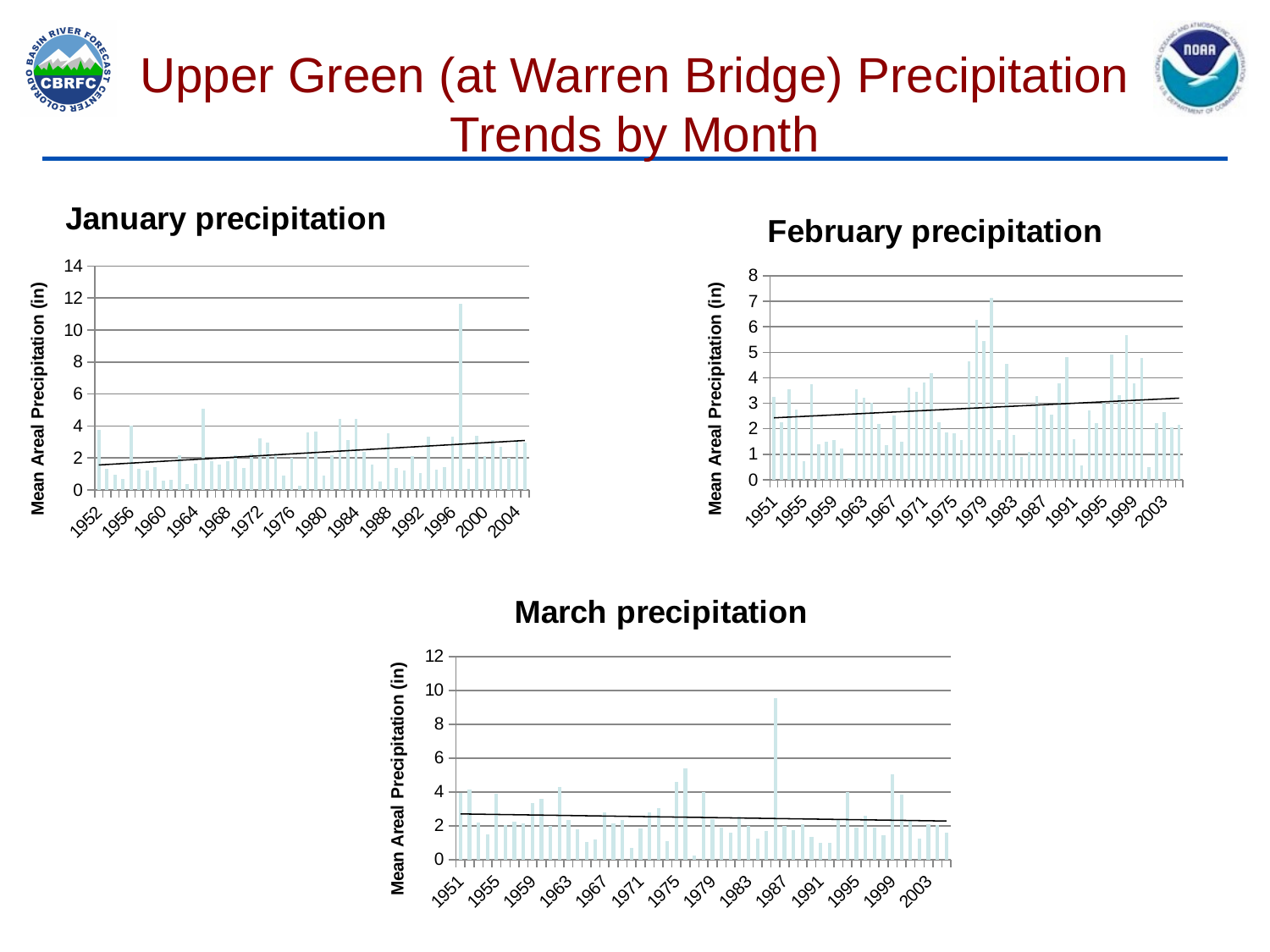
In the March precipitation chart, is the value for 1951 greater or less than 6? less In the February precipitation chart, is the tallest bar greater or less than 6? greater In the January precipitation chart, does the trend line rise or fall from left to right? rise In the March precipitation chart, is the tallest bar greater or less than 8? greater In the March precipitation chart, does the trend line rise or fall from left to right? fall In the February precipitation chart, does the trend line rise or fall from left to right? rise What kind of chart is the January precipitation chart? bar chart What is the y-axis label on the March precipitation chart? Mean Areal Precipitation (in) What is the highest value shown on the y axis of the February precipitation chart? 8